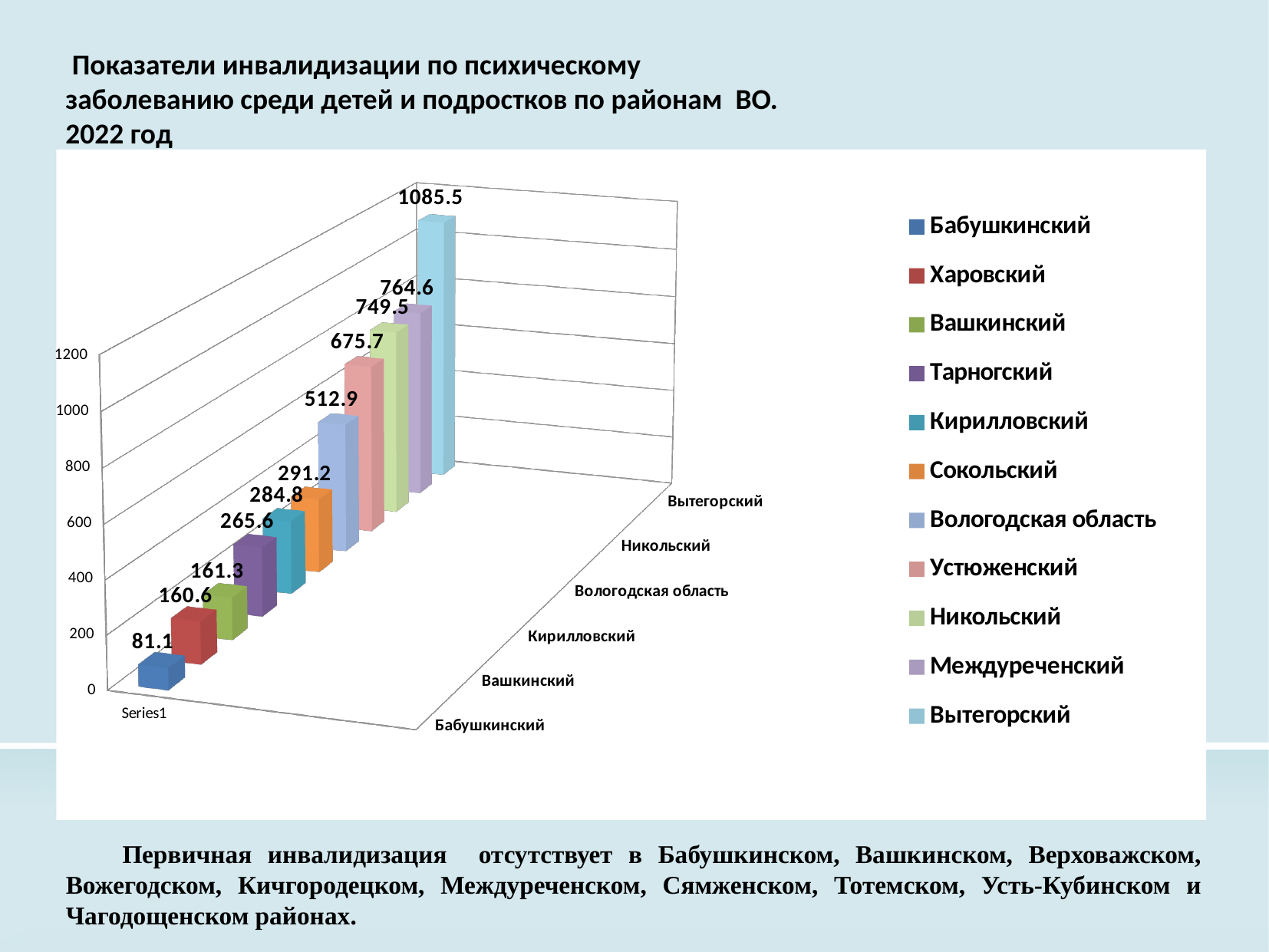
What is the value for Вологодская область? 512.9 What colour is the bar for Сокольский? Orange Which district has the lowest value? Бабушкинский What is the value for Устюженский? 675.7 What kind of chart is shown on the slide? Bar chart What is the value for Тарногский? 265.6 Which district has the highest value? Вытегорский What is the difference between the values for Вытегорский and Бабушкинский? 1004.4 What is the difference between the values for Вологодская область and Сокольский? 221.7 What is the value for Вытегорский? 1085.5 How many series does the legend list? 11 Which is larger, the value for Никольский or the value for Кирилловский? Никольский